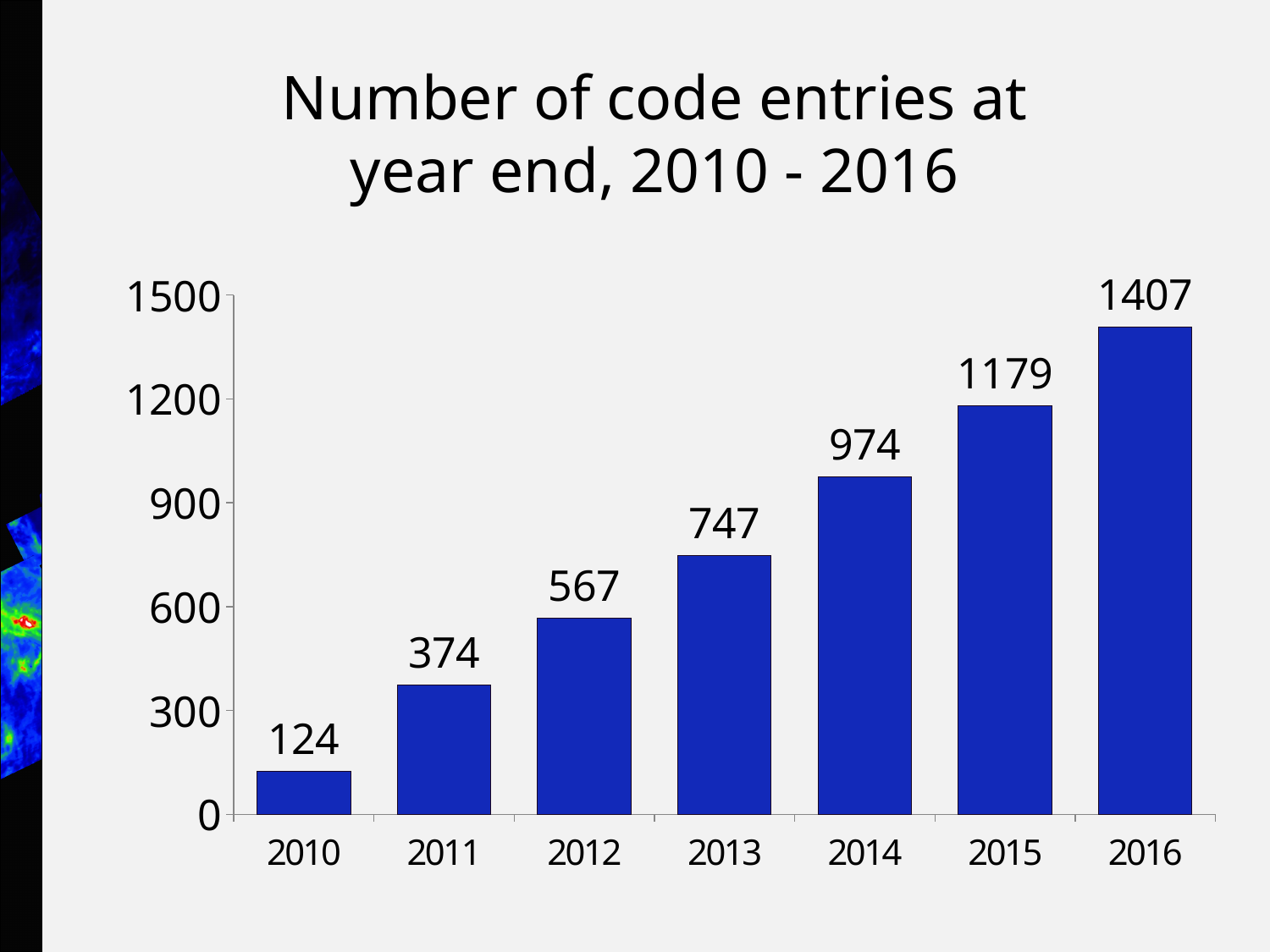
How many years are shown on the x axis? 7 Do the values rise or fall from 2010 to 2016? Rise Which year has the lowest number of code entries? 2010 What is the difference between the values for 2012 and 2011? 193 Is the value for 2015 greater or less than 900? greater What kind of chart is shown on the slide? Bar chart What is the difference between the values for 2016 and 2015? 228 What is the number of code entries at year end for 2013? 747 Which year has the highest number of code entries? 2016 Which is larger, the value for 2014 or the value for 2013? 2014 What is the value shown for 2016? 1407 What is the value shown for 2010? 124